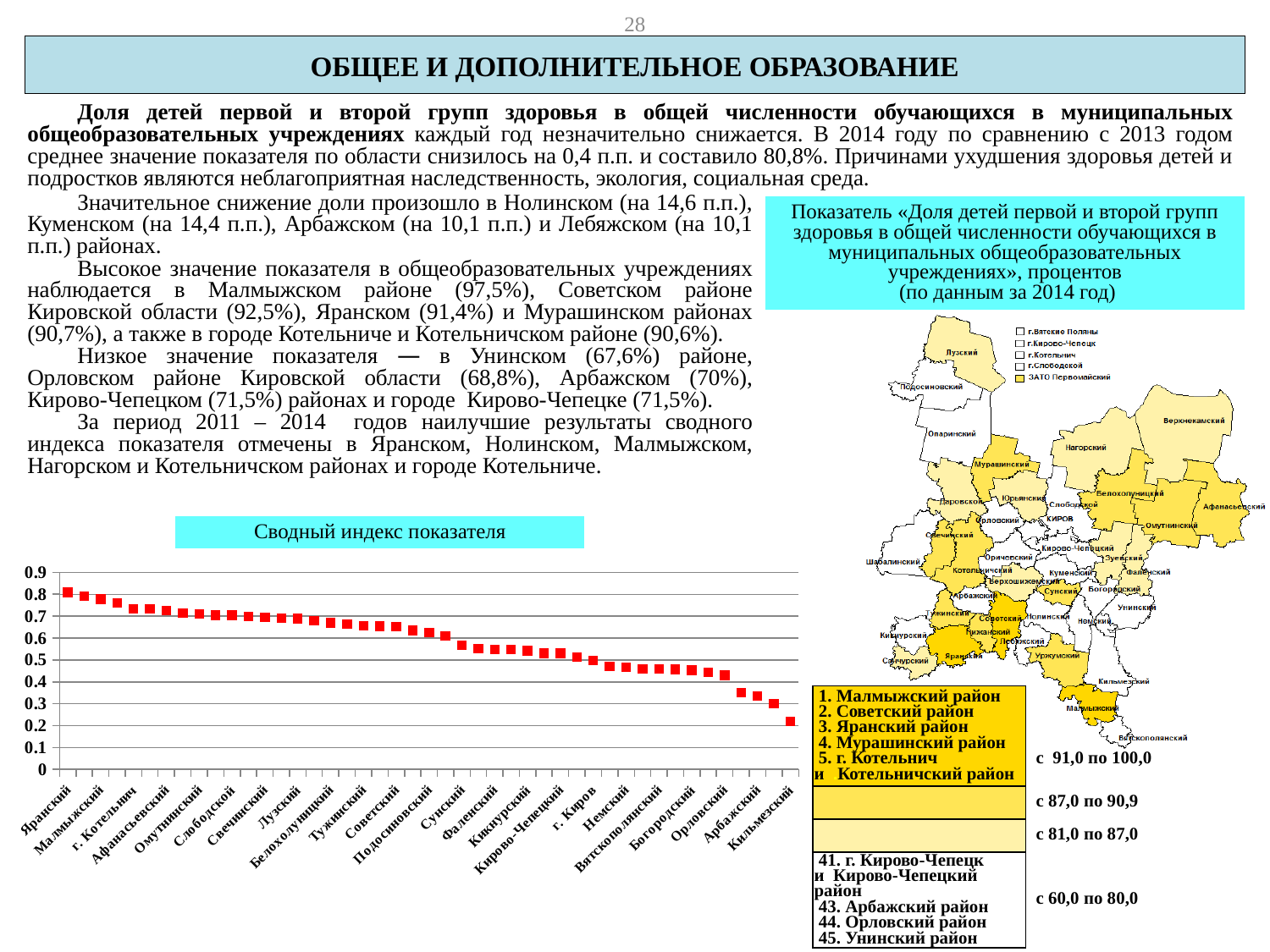
In the chart "Сводный индекс показателя", which has the larger value, Малмыжский or Арбажский? Малмыжский In the chart "Сводный индекс показателя", which category has the highest value? Яранский In the chart "Сводный индекс показателя", is the value for Малмыжский greater or less than 0.7? greater What is the title of the chart on the slide? Сводный индекс показателя In the chart "Сводный индекс показателя", which has the larger value, Яранский or Кильмезский? Яранский In the chart "Сводный индекс показателя", is the value for Советский greater or less than 0.6? greater In the chart "Сводный индекс показателя", is the value for Арбажский greater or less than 0.4? less In the chart "Сводный индекс показателя", which category has the lowest value? Кильмезский In the chart "Сводный индекс показателя", do the values rise or fall from left to right along the x axis? fall What is the highest tick value shown on the y axis of the chart "Сводный индекс показателя"? 0.9